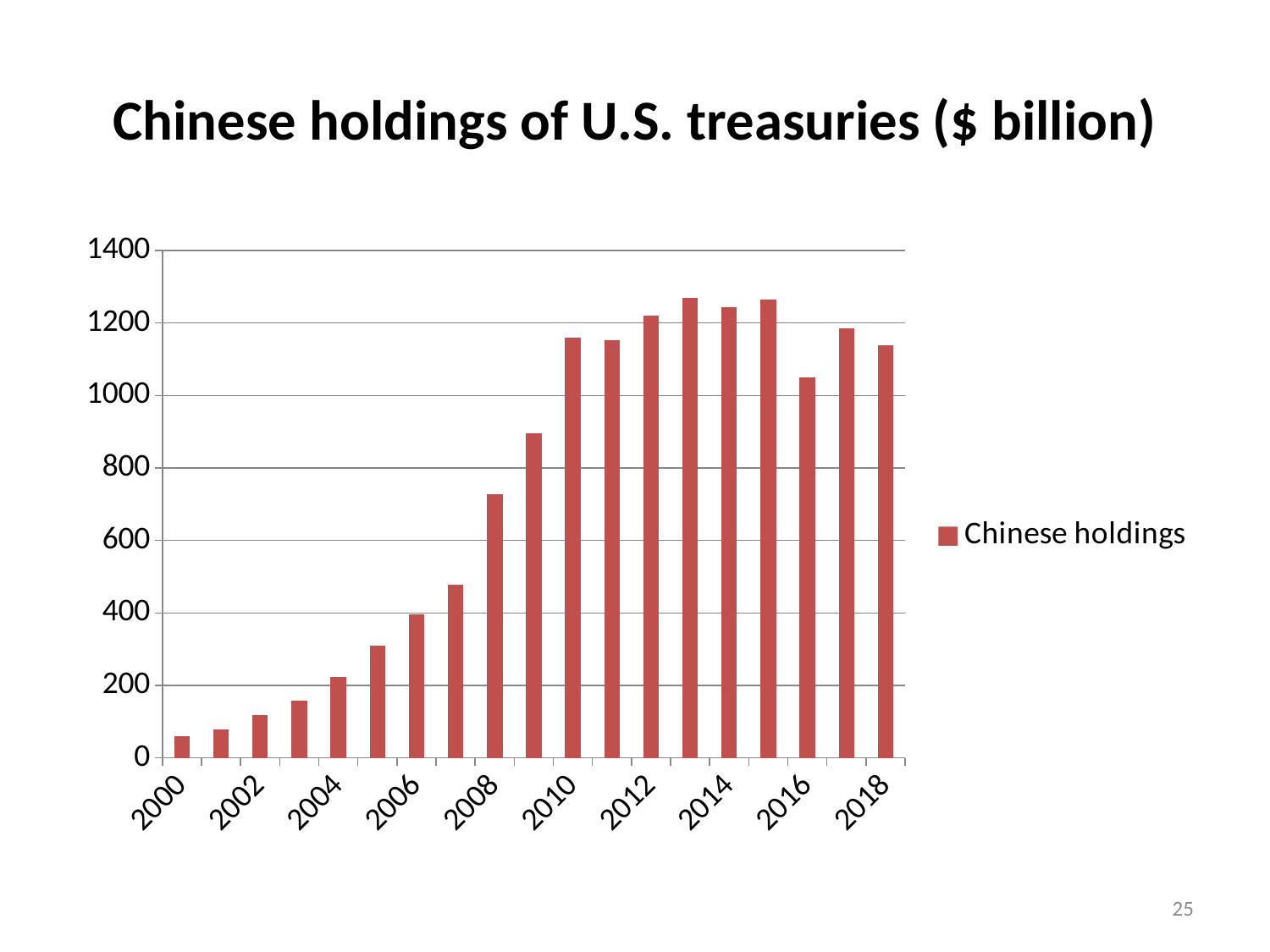
Is the value for 2009 greater or less than 1000? less How many years (bars) are plotted on the chart? 19 How many series does the legend list? 1 Do the values rise or fall from 2000 to 2009? rise What is the legend entry for the series shown on the chart? Chinese holdings Which year has the lowest Chinese holdings of U.S. treasuries? 2000 What kind of chart is shown on the slide? bar chart Is the value for 2008 greater or less than 600? greater Is the value for 2005 greater or less than 200? greater Which year has the larger value, 2015 or 2016? 2015 Which year has the larger value, 2007 or 2008? 2008